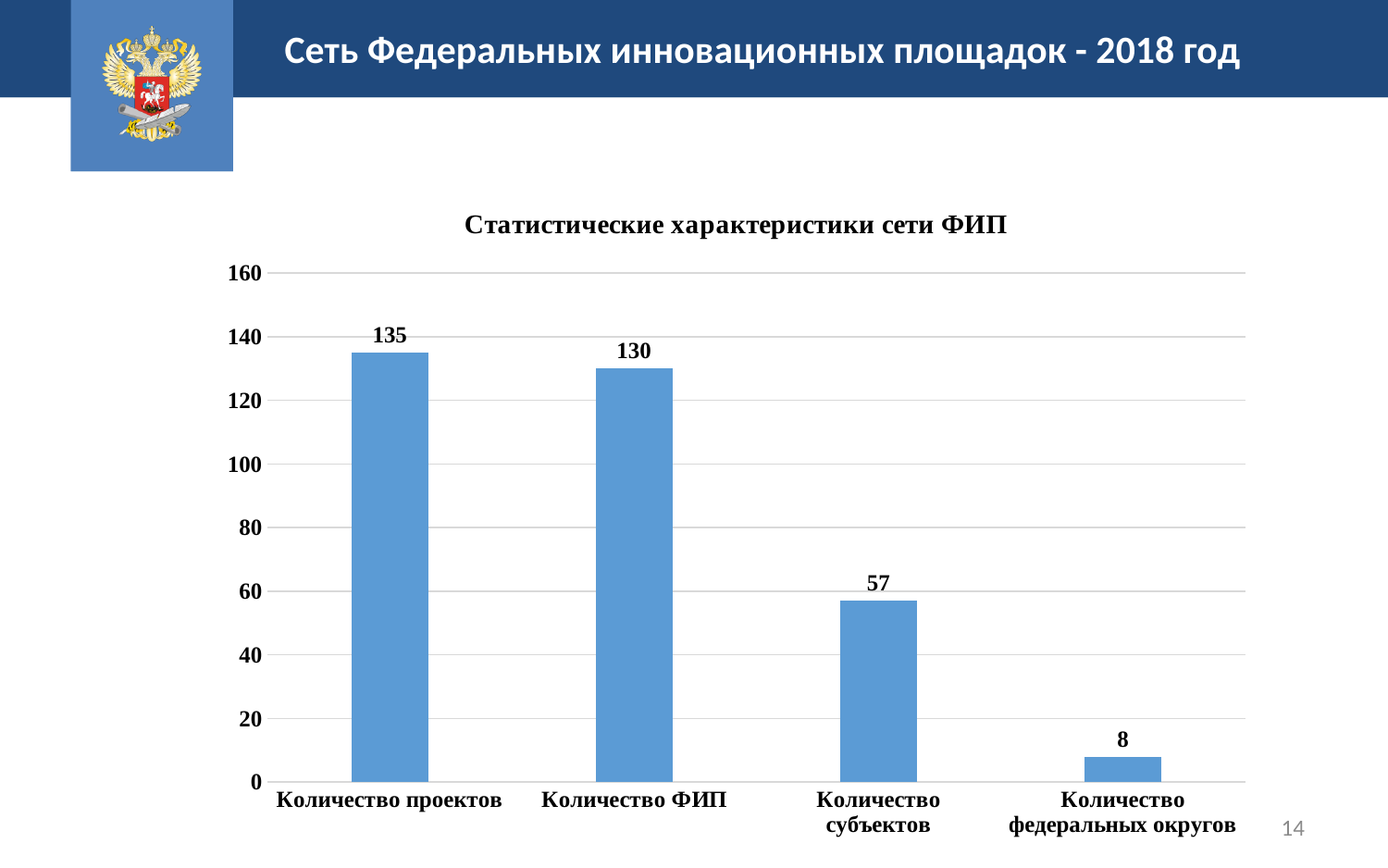
What is the title of the chart? Статистические характеристики сети ФИП What is the value for Количество федеральных округов? 8 Which is larger, Количество субъектов or Количество федеральных округов? Количество субъектов Which category has the lowest value? Количество федеральных округов What is the value for Количество субъектов? 57 What is the value for Количество ФИП? 130 How many categories are shown in the chart? 4 What is the value for Количество проектов? 135 What is the difference between Количество проектов and Количество ФИП? 5 Which category has the highest value? Количество проектов What kind of chart is shown on the slide? Bar chart What is the difference between Количество ФИП and Количество субъектов? 73